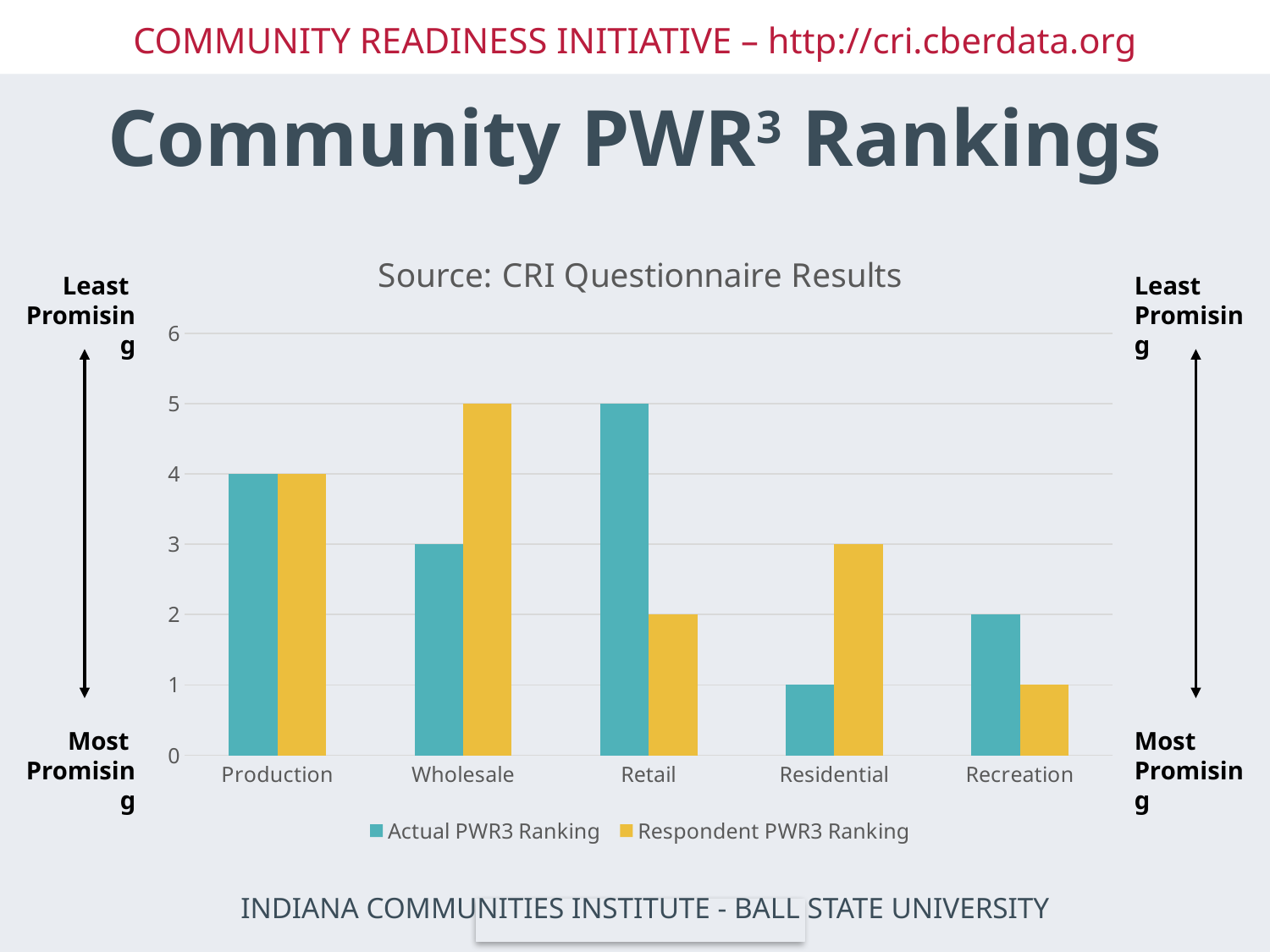
What is the difference between the Actual and Respondent PWR3 Rankings for Retail? 3 What is the Respondent PWR3 Ranking for Wholesale? 5 What is the Actual PWR3 Ranking for Retail? 5 Which category has the lowest Respondent PWR3 Ranking? Recreation What is the Actual PWR3 Ranking for Residential? 1 How many categories are shown on the x axis? 5 How many series does the legend list? 2 Which colour represents the Respondent PWR3 Ranking series? Yellow What kind of chart is shown on the slide? Bar chart Which category has the highest Actual PWR3 Ranking? Retail For Residential, which is larger: the Actual PWR3 Ranking or the Respondent PWR3 Ranking? Respondent PWR3 Ranking What is the title of the chart? Source: CRI Questionnaire Results